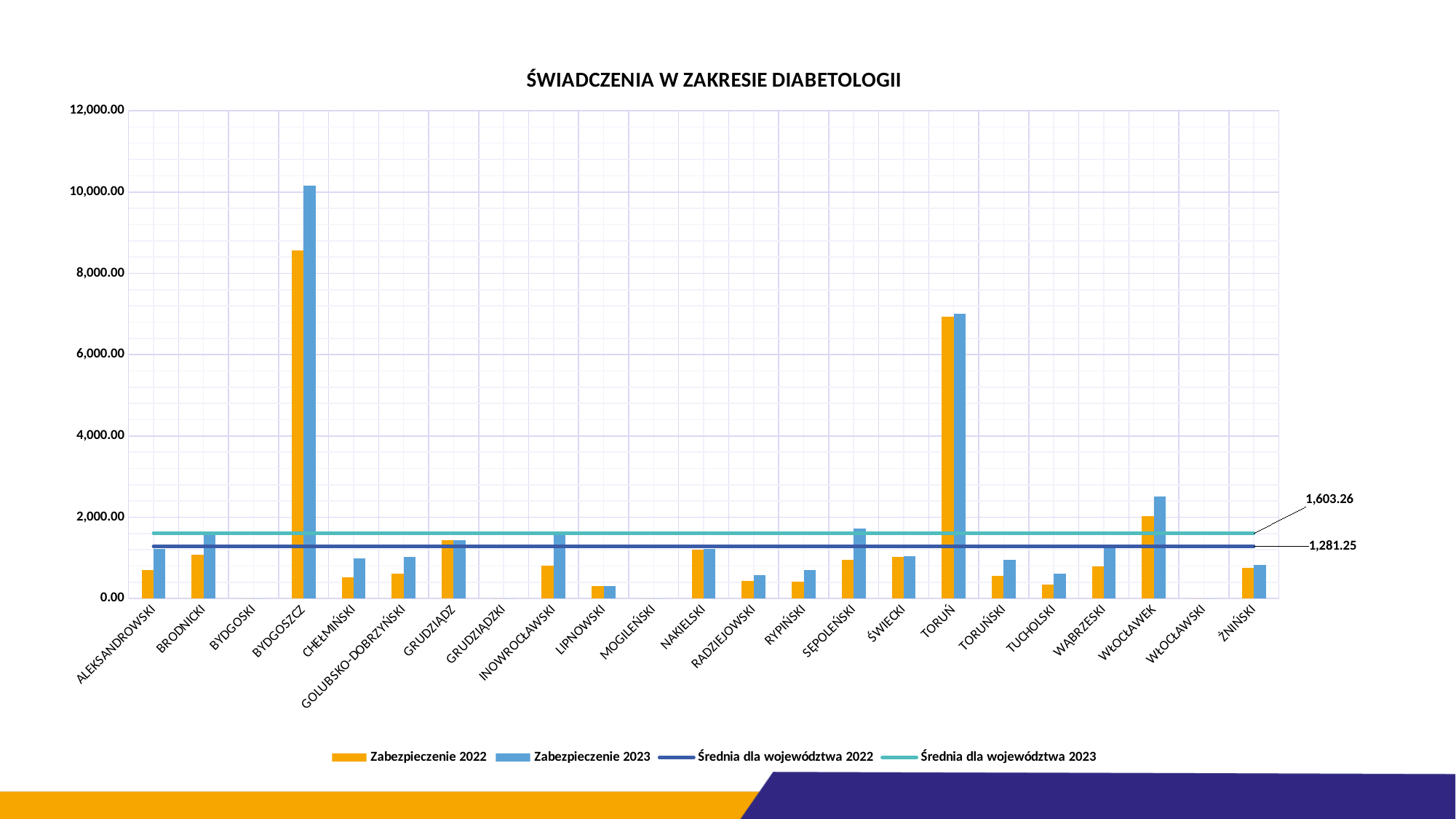
How many categories are shown on the x axis of the chart? 23 Which category has the highest Zabezpieczenie 2022 value? BYDGOSZCZ How many entries does the chart legend list? 4 What kind of chart is shown on the slide? combination bar and line chart Is the Zabezpieczenie 2022 value for TORUŃ greater or less than 8,000.00? less What is the value of the Średnia dla województwa 2023 line? 1,603.26 Which category has the highest Zabezpieczenie 2023 value? BYDGOSZCZ What is the title of the chart? ŚWIADCZENIA W ZAKRESIE DIABETOLOGII Which has the larger Zabezpieczenie 2023 value, WŁOCŁAWEK or GRUDZIĄDZ? WŁOCŁAWEK Is the Zabezpieczenie 2023 value for BYDGOSZCZ greater or less than 10,000.00? greater What is the difference between the Średnia dla województwa 2023 and Średnia dla województwa 2022 values? 322.01 What is the value of the Średnia dla województwa 2022 line? 1,281.25